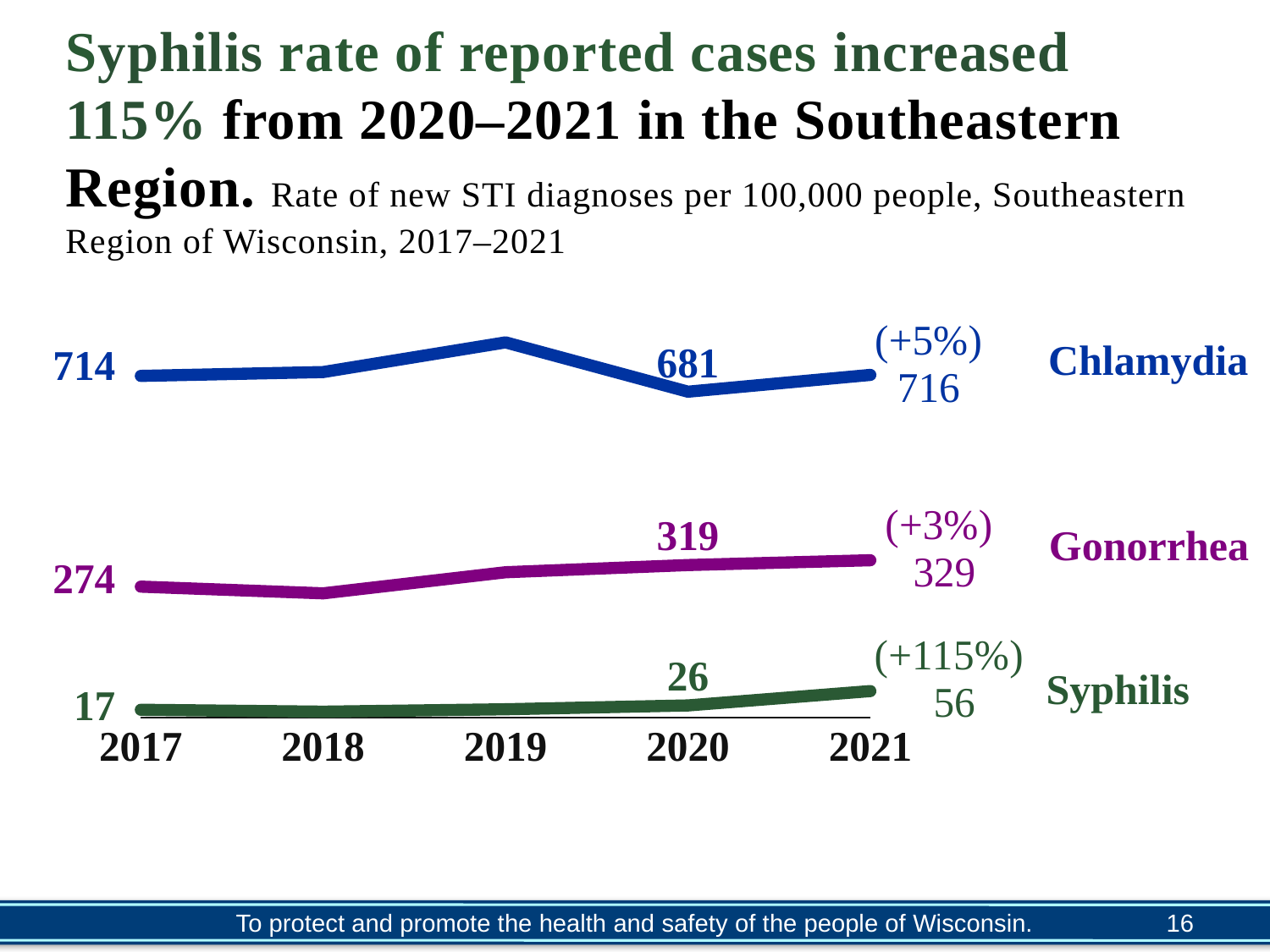
How many STIs (series) are plotted on the chart? 3 Which STI had the lowest rate in 2017? Syphilis What was the chlamydia rate in 2020? 681 What type of chart is shown on the slide? Line chart What is the difference between the gonorrhea rate in 2017 and in 2021? 55 Which was larger, the chlamydia rate in 2017 or in 2021? 2021 By how much did the syphilis rate change from 2020 to 2021? 30 What was the gonorrhea rate in 2021? 329 How many years are shown on the x axis? 5 Which STI had the highest rate in 2021? Chlamydia What was the syphilis rate in 2020? 26 What was the chlamydia rate in 2017? 714